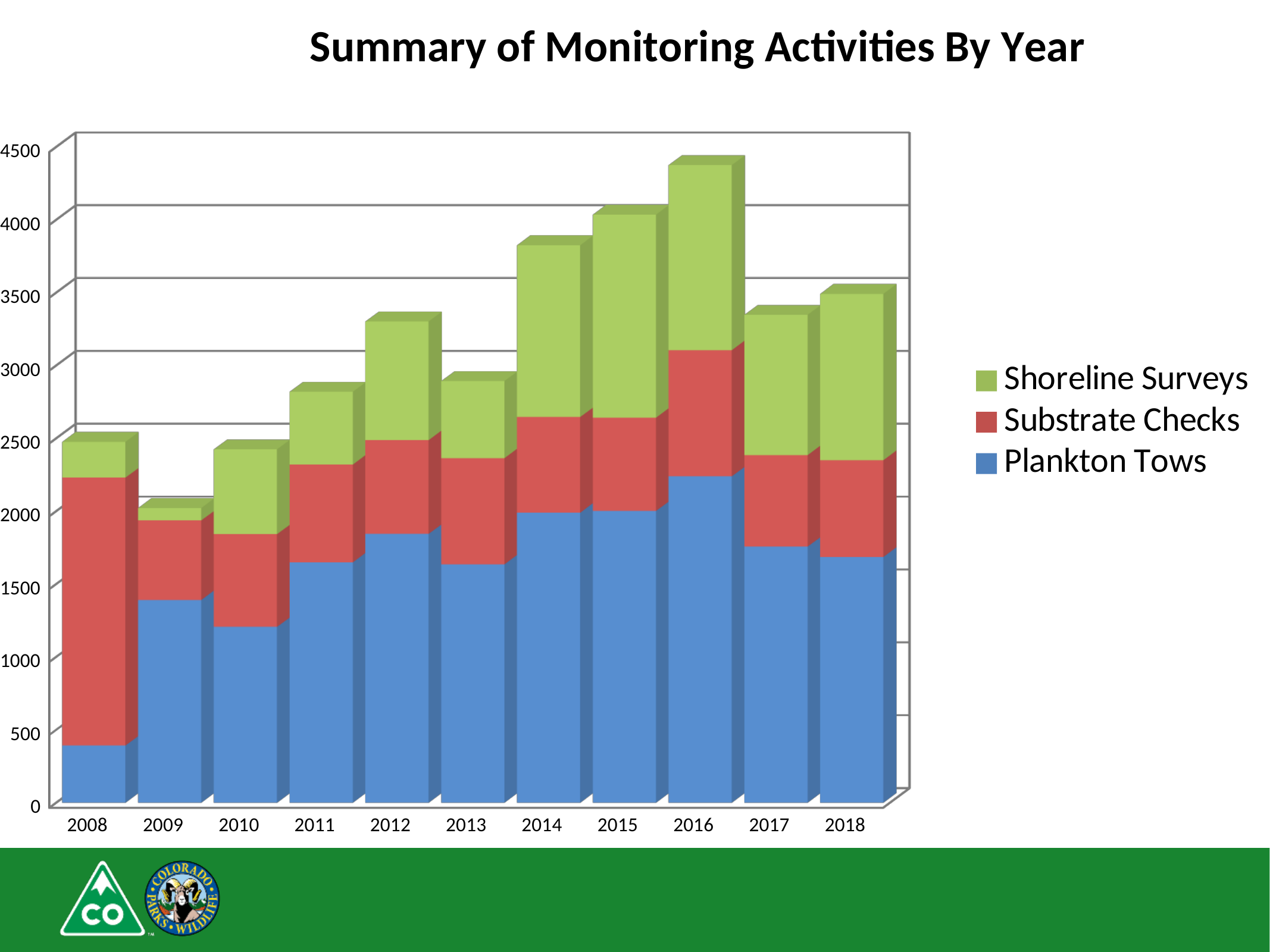
Which year has the larger total of monitoring activities, 2014 or 2013? 2014 How many years are shown along the x axis of the chart? 11 Is the total stacked bar for 2016 greater or less than 4000? greater Which year has the shortest stacked bar (lowest total monitoring activities)? 2009 What kind of chart is shown on the slide? Stacked bar chart Which series is shown in green in the chart? Shoreline Surveys Which year has the smallest Plankton Tows segment? 2008 What is the title of the chart? Summary of Monitoring Activities By Year Is the total stacked bar for 2009 greater or less than 2500? less Do the total monitoring activities rise or fall from 2013 to 2016? rise How many series does the chart legend list? 3 Which year has the tallest stacked bar (highest total monitoring activities)? 2016